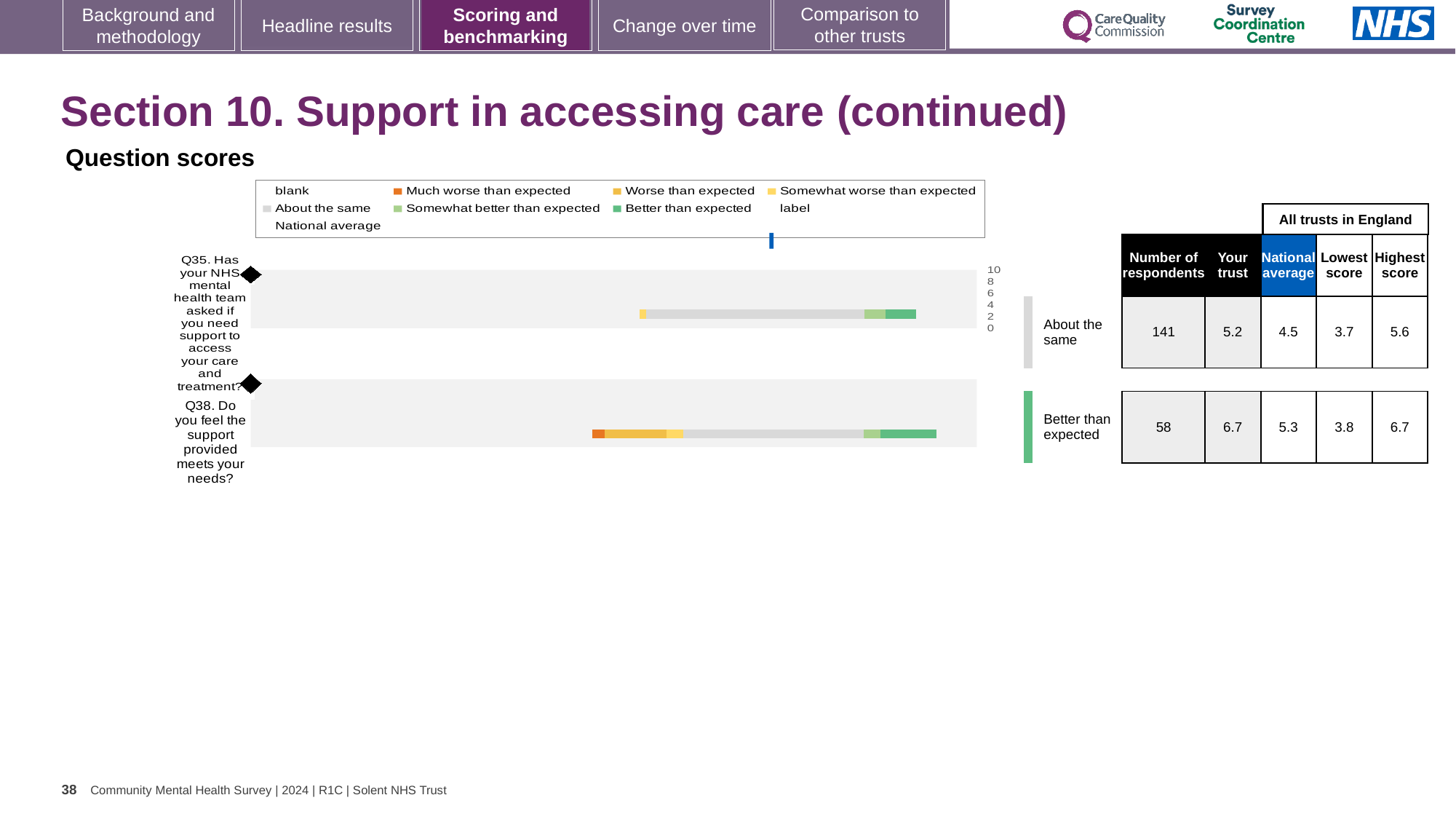
How many questions are plotted in the chart? 2 What benchmark category is the trust's result for Q38 placed in? Better than expected What is the 'Your trust' score for Q35 (Has your NHS mental health team asked if you need support to access your care and treatment?)? 5.2 What is the national average score for Q35? 4.5 What is the difference between the trust's score and the national average for Q38? 1.4 What is the highest score among all trusts in England for Q38? 6.7 What is the 'Your trust' score for Q38 (Do you feel the support provided meets your needs?)? 6.7 What is the lowest score among all trusts in England for Q35? 3.7 How many respondents answered Q38? 58 What is the difference between the trust's score and the national average for Q35? 0.7 Which question has the higher 'Your trust' score, Q35 or Q38? Q38 What kind of chart is used to show the question scores? Bar chart